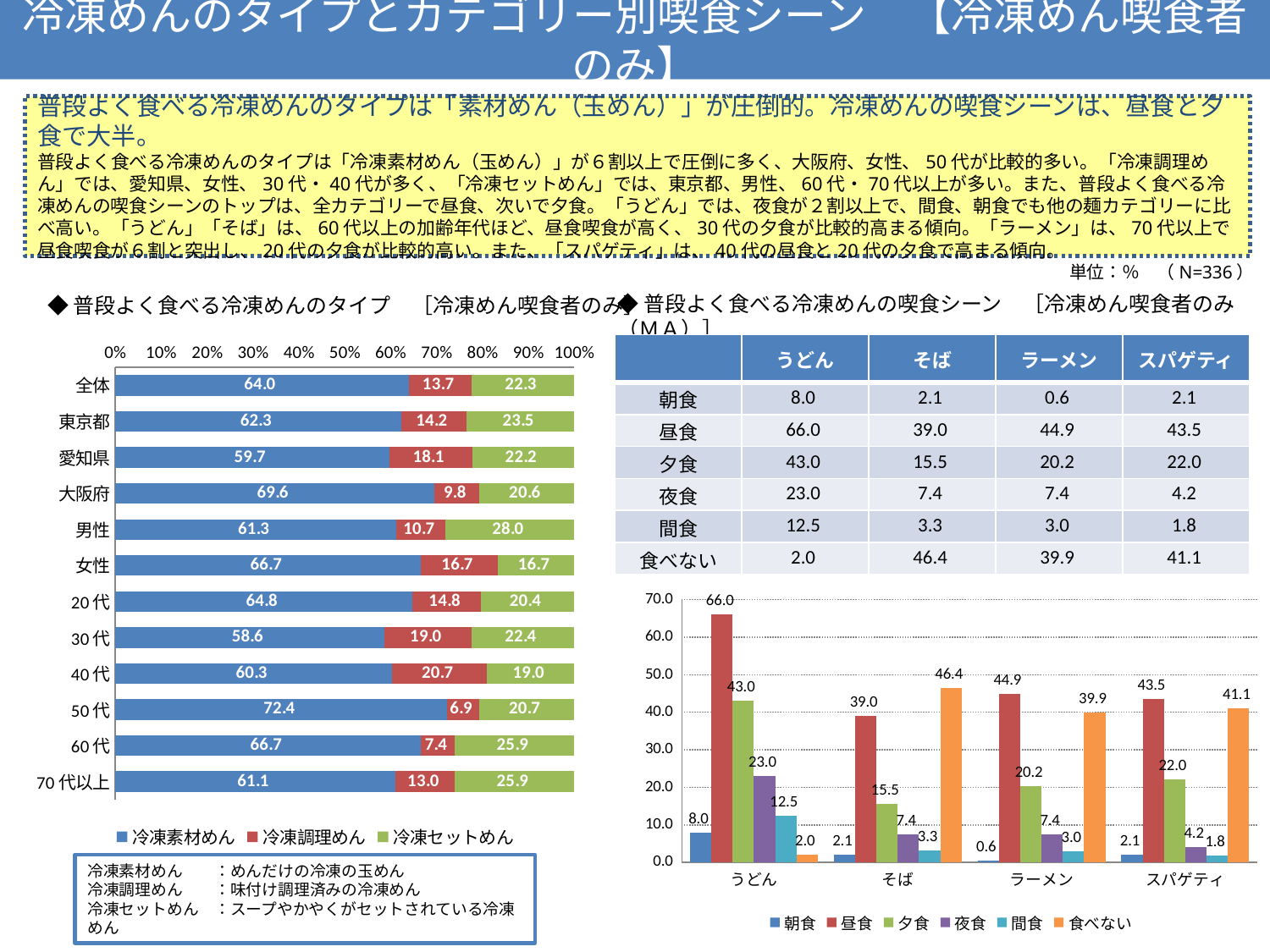
In the right chart (普段よく食べる冷凍めんの喫食シーン), what is the difference between the 昼食 values for うどん and そば? 27.0 In the left chart (普段よく食べる冷凍めんのタイプ), which category has the lowest value for 冷凍調理めん? 50代 In the left chart (普段よく食べる冷凍めんのタイプ), what is the difference between the 冷凍セットめん values for 男性 and 女性? 11.3 In the right chart (普段よく食べる冷凍めんの喫食シーン), how many series does the legend list? 6 In the right chart (普段よく食べる冷凍めんの喫食シーン), which is larger for うどん: 夕食 or 夜食? 夕食 In the left chart (普段よく食べる冷凍めんのタイプ), how many series does the legend list? 3 In the left chart (普段よく食べる冷凍めんのタイプ), what is the value of 冷凍素材めん for 全体? 64.0 In the left chart (普段よく食べる冷凍めんのタイプ), how many categories are shown on the vertical axis? 12 In the left chart (普段よく食べる冷凍めんのタイプ), which category has the highest value for 冷凍素材めん? 50代 What kind of chart is the left chart (普段よく食べる冷凍めんのタイプ)? Stacked bar chart In the right chart (普段よく食べる冷凍めんの喫食シーン), what is the value of 昼食 for ラーメン? 44.9 In the right chart (普段よく食べる冷凍めんの喫食シーン), which category has the highest value for 食べない? そば